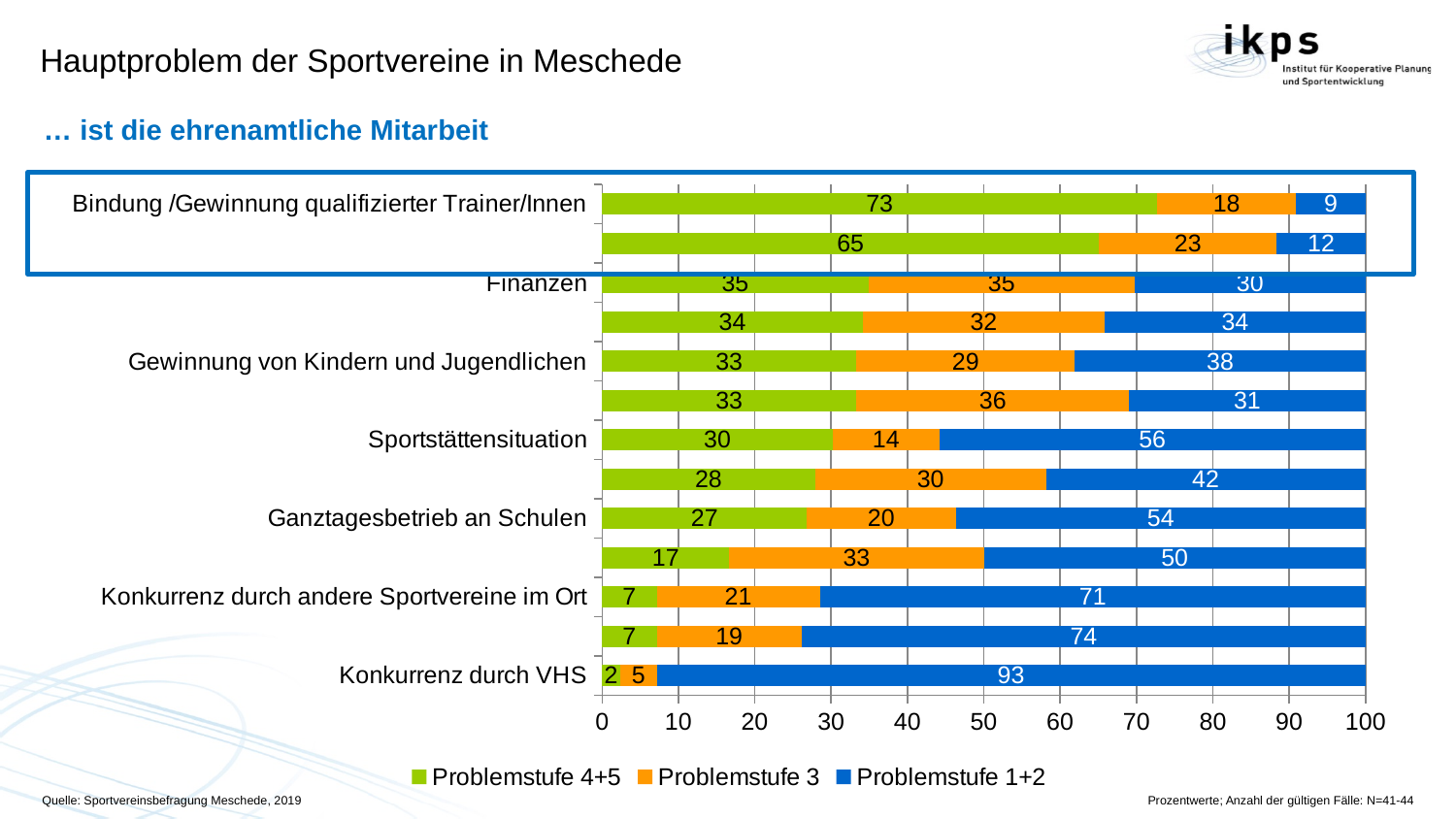
What is the Problemstufe 1+2 value for Konkurrenz durch VHS? 93 What is the Problemstufe 3 value for Sportstättensituation? 14 What is the Problemstufe 1+2 value for Finanzen? 30 How much larger is the Problemstufe 1+2 value for Konkurrenz durch VHS than for Konkurrenz durch andere Sportvereine im Ort? 22 Which category has the highest Problemstufe 4+5 value? Bindung /Gewinnung qualifizierter Trainer/Innen What is the Problemstufe 3 value for Gewinnung von Kindern und Jugendlichen? 29 What is the Problemstufe 4+5 value for Bindung /Gewinnung qualifizierter Trainer/Innen? 73 What is the total of the stacked bar for Sportstättensituation? 100 Which category has the lowest Problemstufe 4+5 value? Konkurrenz durch VHS What kind of chart is shown on the slide? Stacked bar chart How many series does the legend list? 3 Which has the larger Problemstufe 4+5 value, Finanzen or Ganztagesbetrieb an Schulen? Finanzen